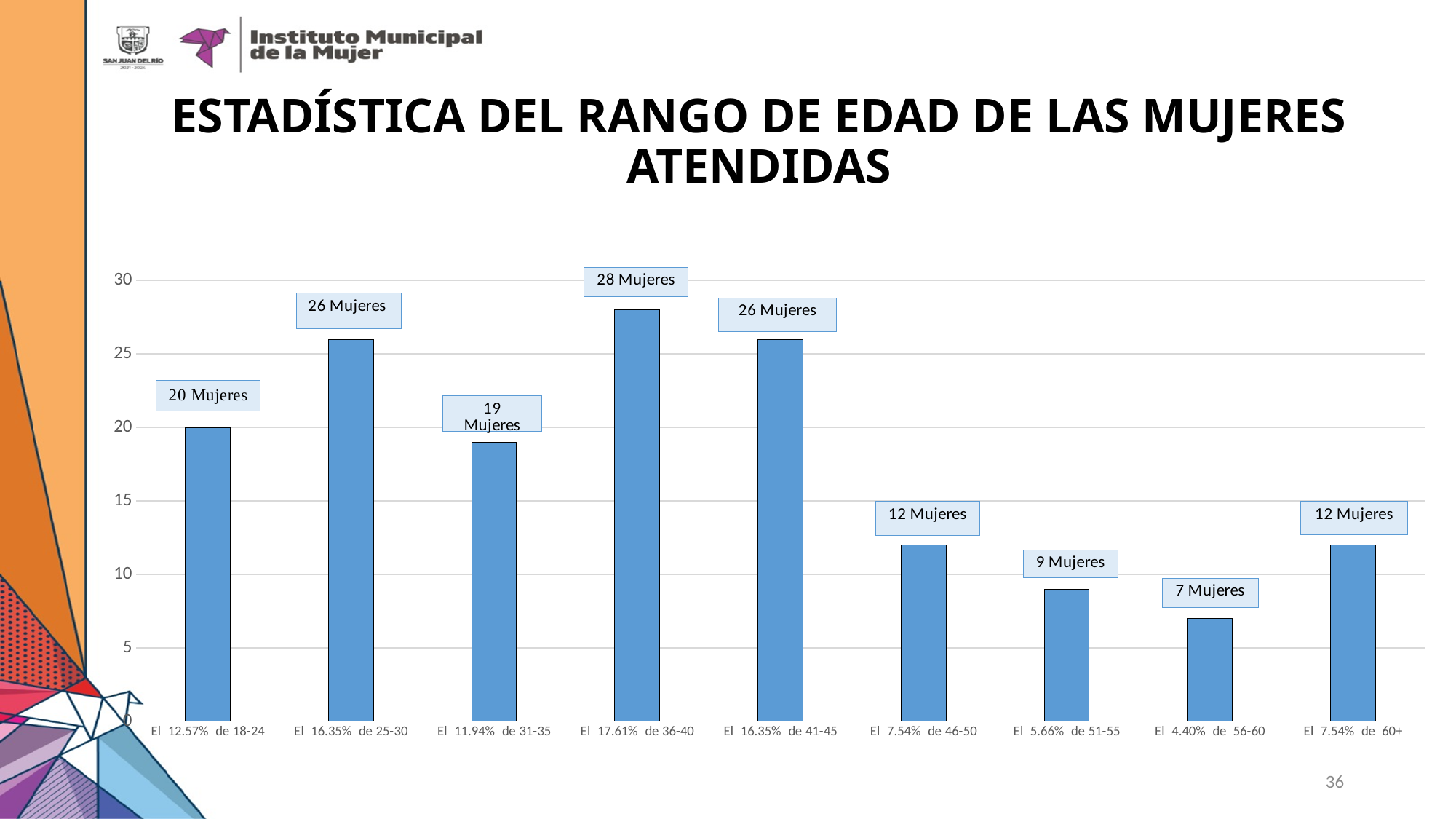
How many women are in the 36-40 age range? 28 Mujeres Which age range has the highest number of women attended? 36-40 How many women are in the 18-24 age range? 20 Mujeres What percentage is shown for the 41-45 age range? 16.35% What is the difference between the number of women in the 36-40 range and the 31-35 range? 9 Which age range has the lowest number of women attended? 56-60 How many age ranges are shown on the chart? 9 Is the value for the 25-30 age range greater or less than 25? greater What kind of chart is shown on the slide? Bar chart How many women are in the 56-60 age range? 7 Mujeres Which has more women, the 46-50 range or the 51-55 range? 46-50 What is the title of the slide? ESTADÍSTICA DEL RANGO DE EDAD DE LAS MUJERES ATENDIDAS